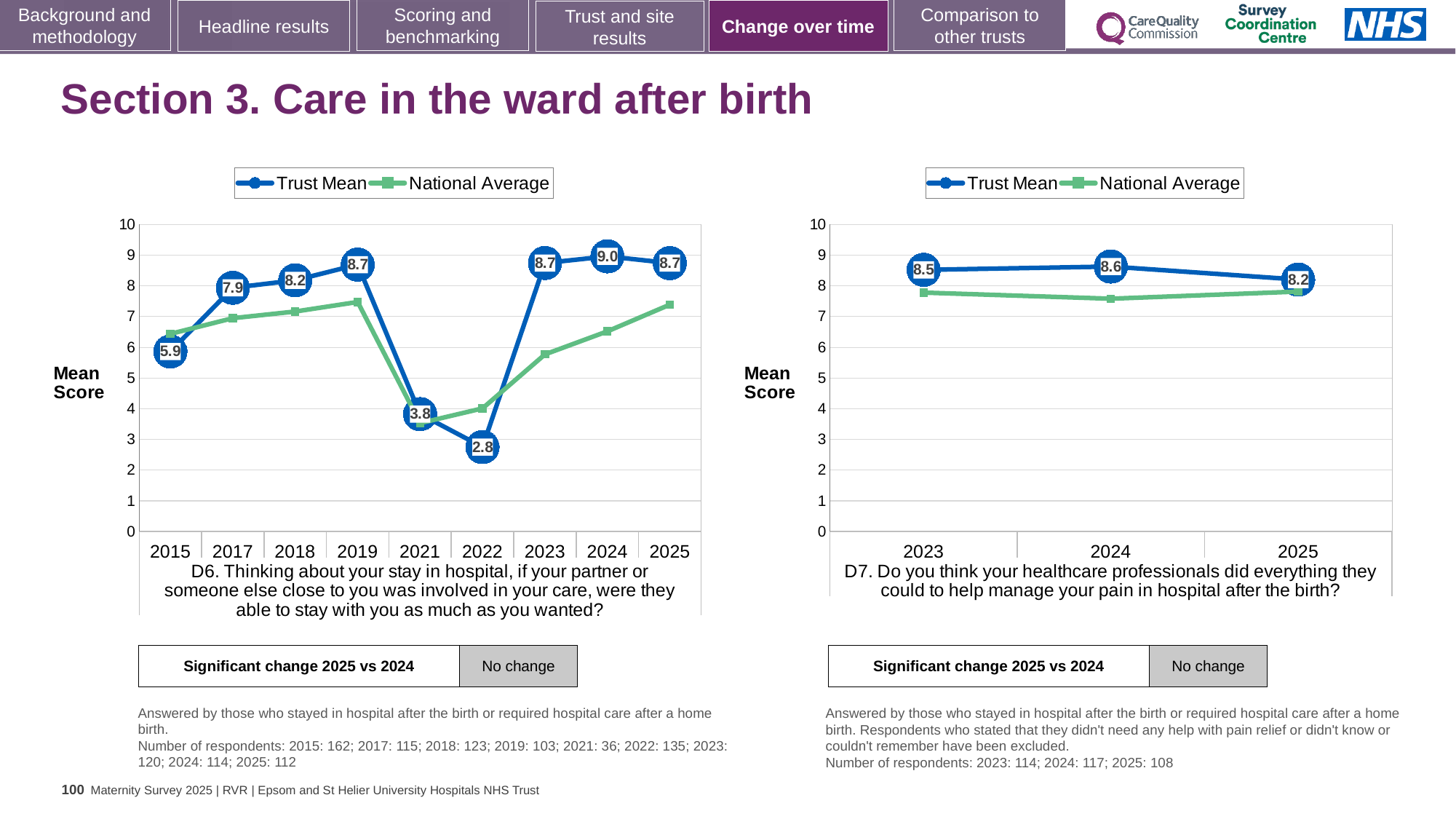
In the left chart (D6), what is the Trust Mean for 2022? 2.8 In the right chart (D7), is the Trust Mean for 2024 larger than the Trust Mean for 2025? Yes In the left chart (D6), what is the Trust Mean for 2024? 9.0 In the right chart (D7), what is the Trust Mean for 2025? 8.2 In the right chart (D7), is the National Average for 2024 greater or less than 8? less In the right chart (D7), which year has the highest Trust Mean? 2024 In the left chart (D6), how many years are shown on the x axis? 9 In the left chart (D6), is the National Average for 2022 greater or less than 5? less In the left chart (D6), which year has the highest Trust Mean? 2024 In the left chart (D6), what is the difference between the Trust Mean for 2019 and the Trust Mean for 2021? 4.9 How many series does the legend of the right chart (D7) list? 2 In the left chart (D6), which year has the lowest Trust Mean? 2022